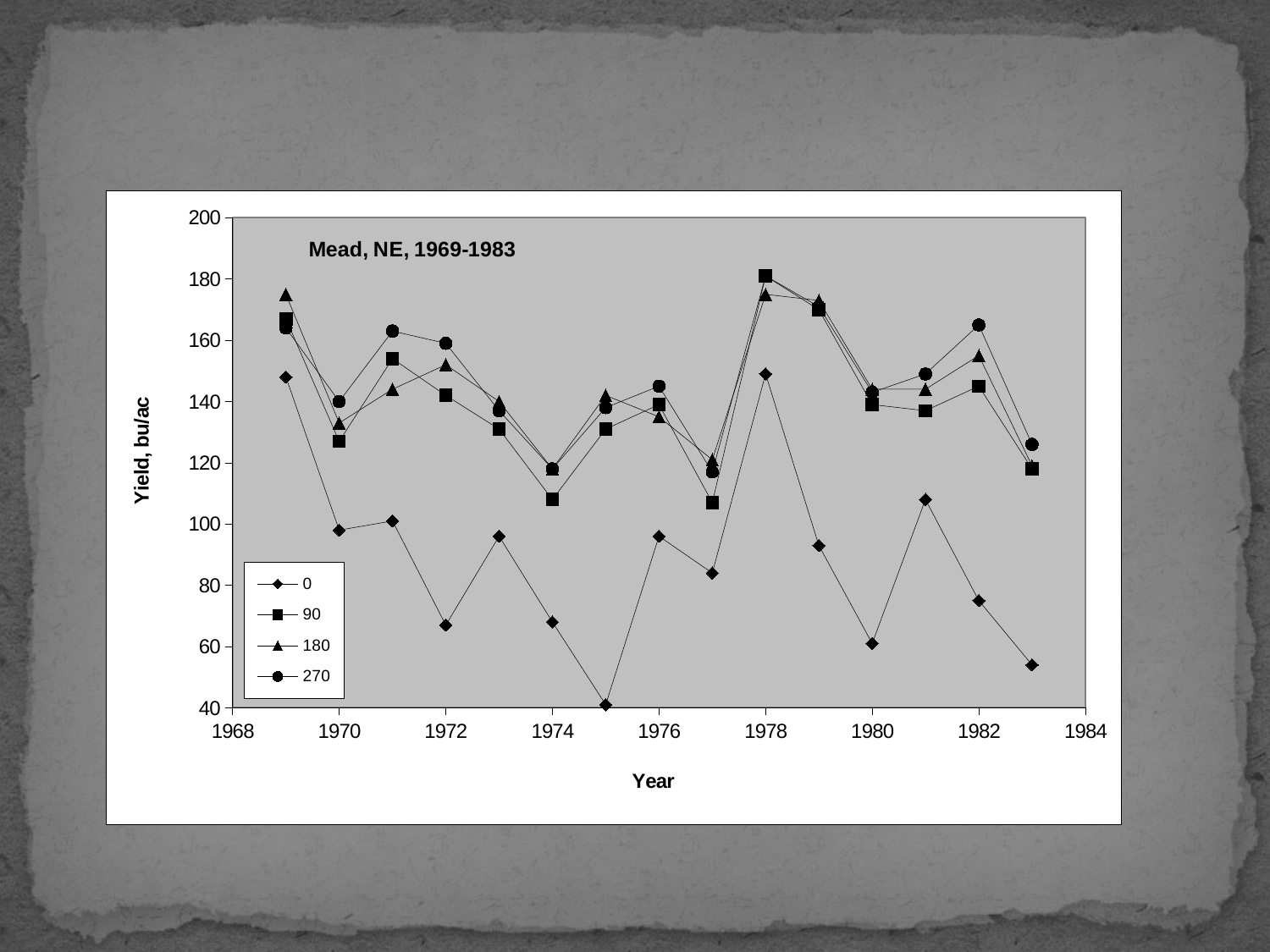
Does the 0 series rise or fall from 1981 to 1983? fall How many years are plotted for each series? 15 What kind of chart is shown on the slide? line chart Is the value for the 0 series in 1969 greater or less than 140? greater Is the value for the 270 series in 1982 greater or less than 160? greater Is the value for the 0 series in 1975 greater or less than 60? less In which year does the 90 series reach its highest value? 1978 Which is larger for the 0 series: the value in 1978 or the value in 1979? 1978 In which year does the 0 series reach its lowest value? 1975 How many series does the legend list? 4 What is the label on the y axis? Yield, bu/ac